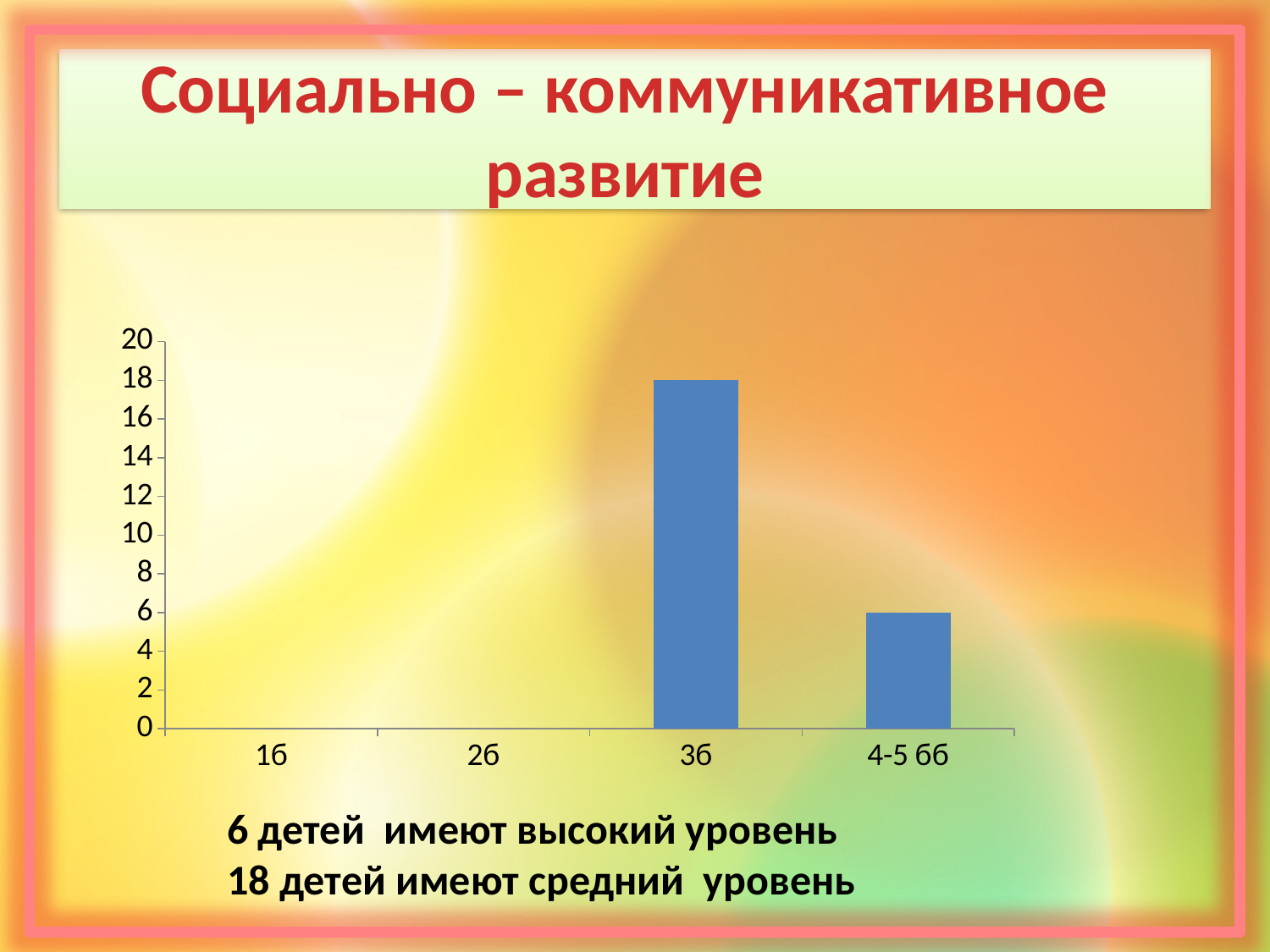
Is the value for 3б greater or less than 10? greater How many categories are shown on the x axis? 4 What is the difference between the values for 3б and 4-5 бб? 12 What kind of chart is shown on the slide? bar chart What is the maximum value shown on the vertical axis? 20 Which is larger, the value for 3б or the value for 4-5 бб? 3б What is the value for the category 4-5 бб? 6 What is the value for the category 3б? 18 Is the value for 4-5 бб greater or less than 10? less Which category has the highest value? 3б What colour are the bars in the chart? blue